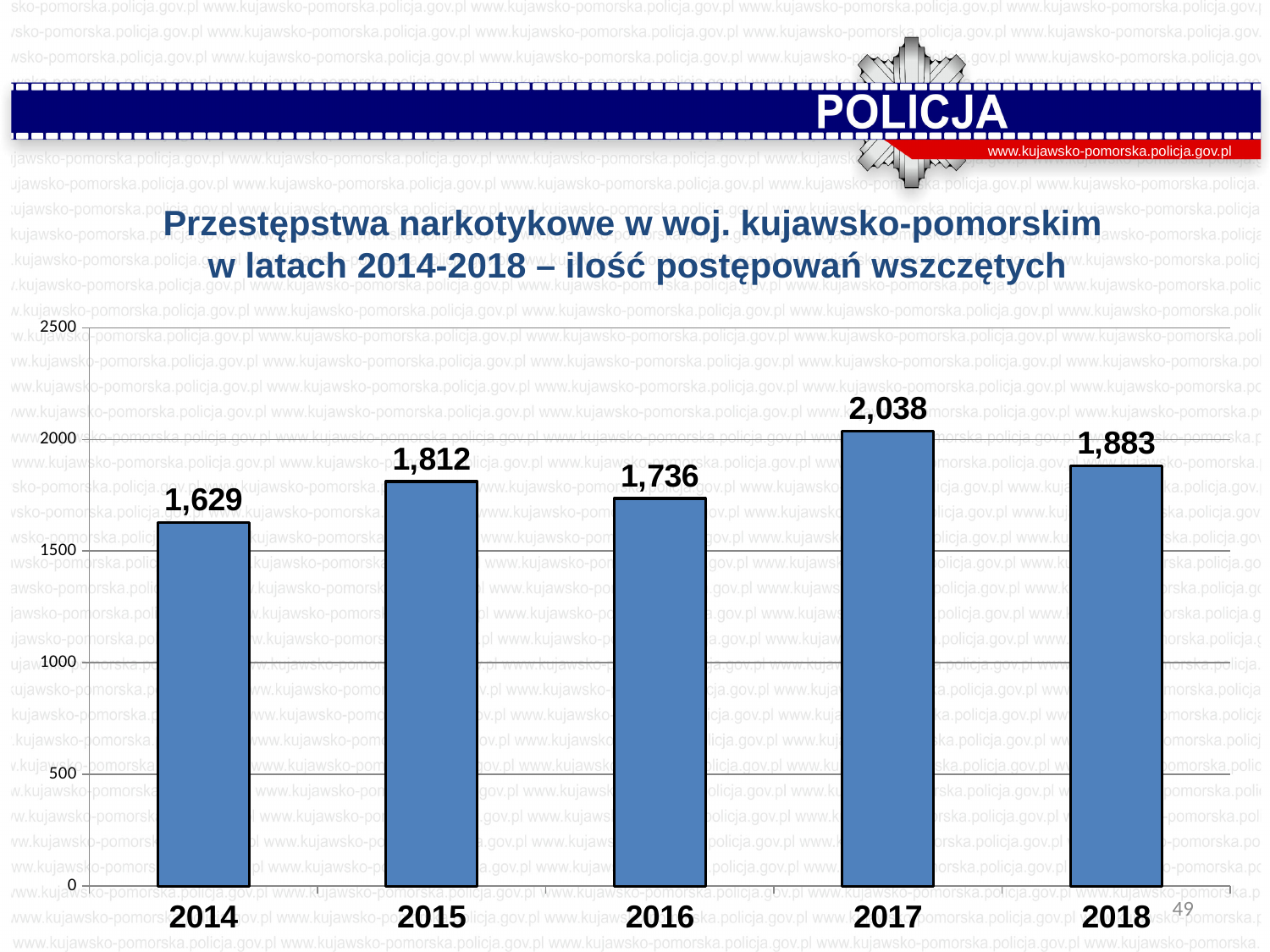
What is the difference between the values for 2017 and 2016? 302 How many years are shown on the chart? 5 What is the value for 2017? 2,038 Does the value rise or fall from 2017 to 2018? fall What kind of chart is shown on the slide? bar chart Is the value for 2017 greater or less than 2000? greater Which year has the highest value? 2017 Which year has the lowest value? 2014 What is the difference between the values for 2015 and 2014? 183 What is the value for 2018? 1,883 What is the value for 2014? 1,629 Which is larger, the value for 2015 or the value for 2016? 2015